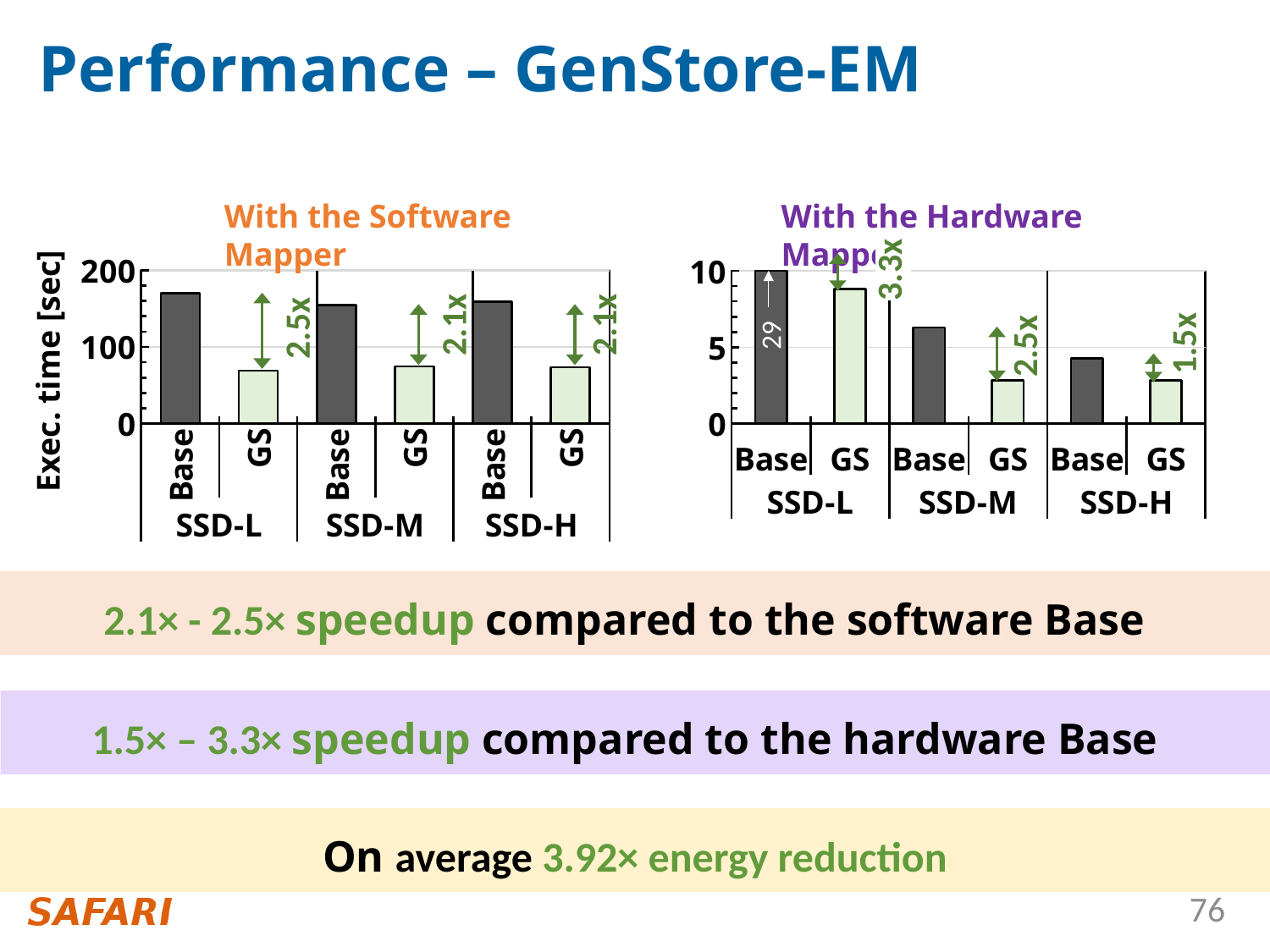
In the 'With the Hardware Mapper' chart, what speedup is annotated for SSD-L? 3.3x In the 'With the Hardware Mapper' chart, what speedup is annotated for SSD-H? 1.5x What kind of chart is the 'With the Software Mapper' chart? bar chart In the 'With the Software Mapper' chart, is the Base value for SSD-L greater or less than 100? greater In the 'With the Hardware Mapper' chart, is the GS value for SSD-L greater or less than 5? greater In the 'With the Software Mapper' chart, which is larger for SSD-H, Base or GS? Base How many SSD configurations are shown in the 'With the Software Mapper' chart? 3 In the 'With the Software Mapper' chart, what speedup is annotated for SSD-L? 2.5x In the 'With the Hardware Mapper' chart, is the Base value for SSD-H greater or less than 5? less In the 'With the Hardware Mapper' chart, what value is printed on the Base bar for SSD-L? 29 In the 'With the Hardware Mapper' chart, which bar is the highest? Base for SSD-L